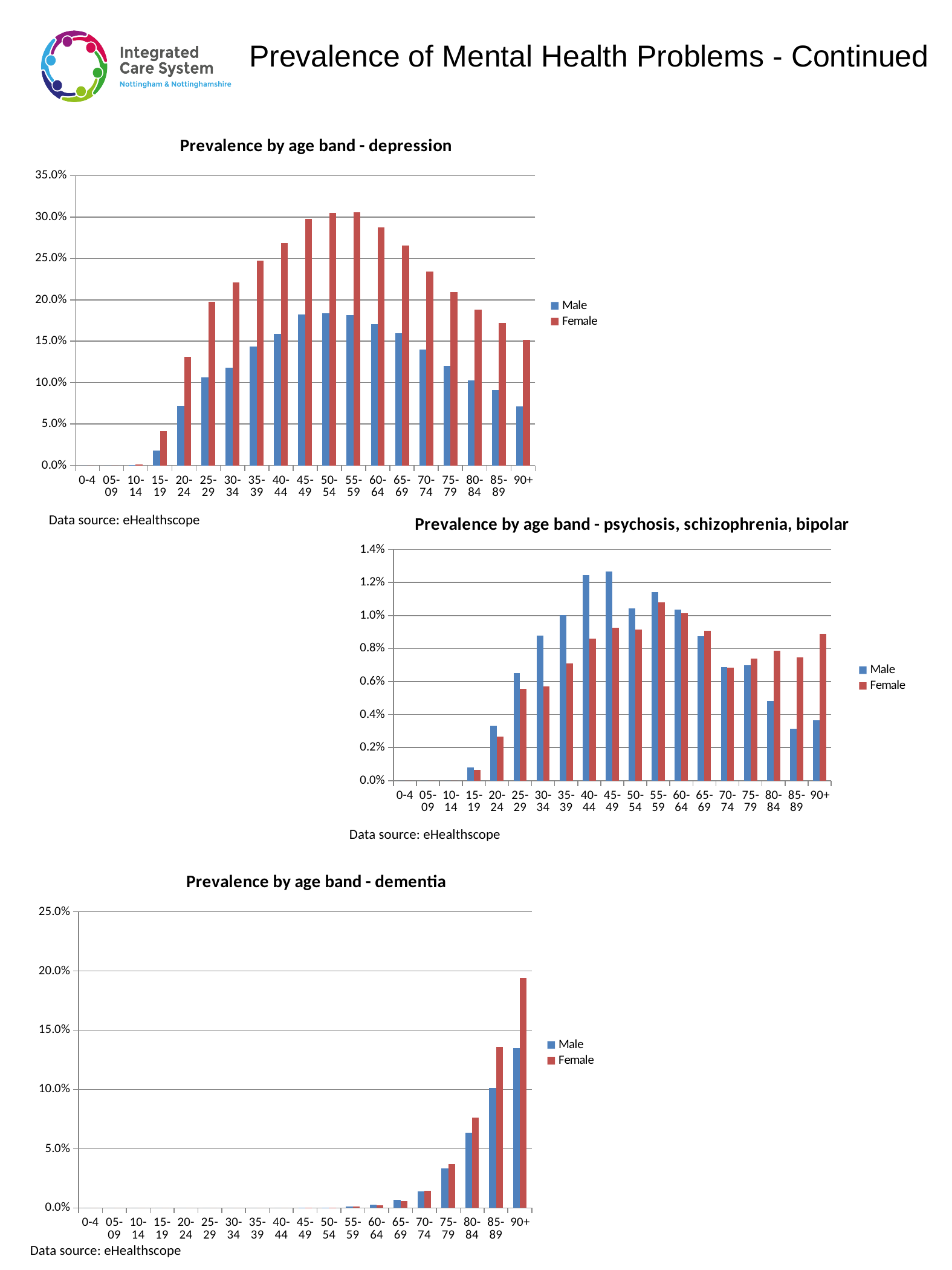
In the 'Prevalence by age band - psychosis, schizophrenia, bipolar' chart, is the Male value for 90+ greater or less than 0.4%? less How many series does the legend list in the 'Prevalence by age band - depression' chart? 2 In the 'Prevalence by age band - dementia' chart, is the Female value for 90+ greater or less than 15.0%? greater In the 'Prevalence by age band - psychosis, schizophrenia, bipolar' chart, which is larger for the 90+ age band, Male or Female? Female In the 'Prevalence by age band - depression' chart, is the Female value for 45-49 greater or less than 25.0%? greater How many age bands are shown on the x axis of the 'Prevalence by age band - dementia' chart? 19 In the 'Prevalence by age band - dementia' chart, do the values generally rise or fall as age increases from 55-59 to 90+? rise What kind of chart is 'Prevalence by age band - dementia'? bar chart In the 'Prevalence by age band - dementia' chart, which age band has the highest Female value? 90+ In the 'Prevalence by age band - psychosis, schizophrenia, bipolar' chart, which is larger for the 40-44 age band, Male or Female? Male In the 'Prevalence by age band - depression' chart, which is larger for the 30-34 age band, Male or Female? Female